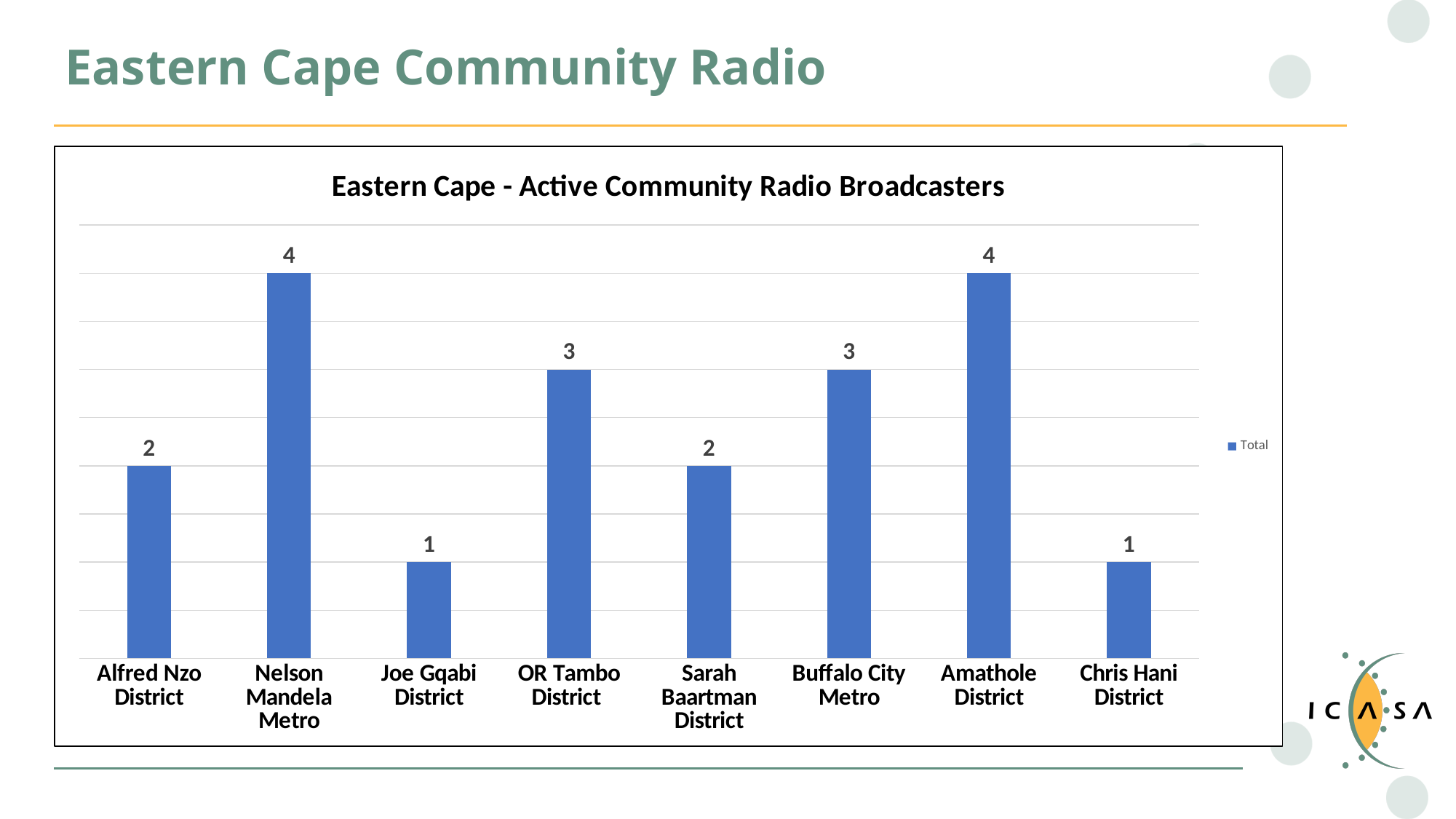
What is the value for OR Tambo District? 3 What is the value for Chris Hani District? 1 How many categories are shown on the x axis? 8 Which categories have the highest value? Nelson Mandela Metro and Amathole District Which categories have the lowest value? Joe Gqabi District and Chris Hani District Which is larger, the value for Buffalo City Metro or the value for Joe Gqabi District? Buffalo City Metro What is the value for Nelson Mandela Metro? 4 What is the title of the chart? Eastern Cape - Active Community Radio Broadcasters What kind of chart is this? Bar chart What is the difference between the values for Amathole District and Alfred Nzo District? 2 What is the value for Sarah Baartman District? 2 How many series does the legend list? 1